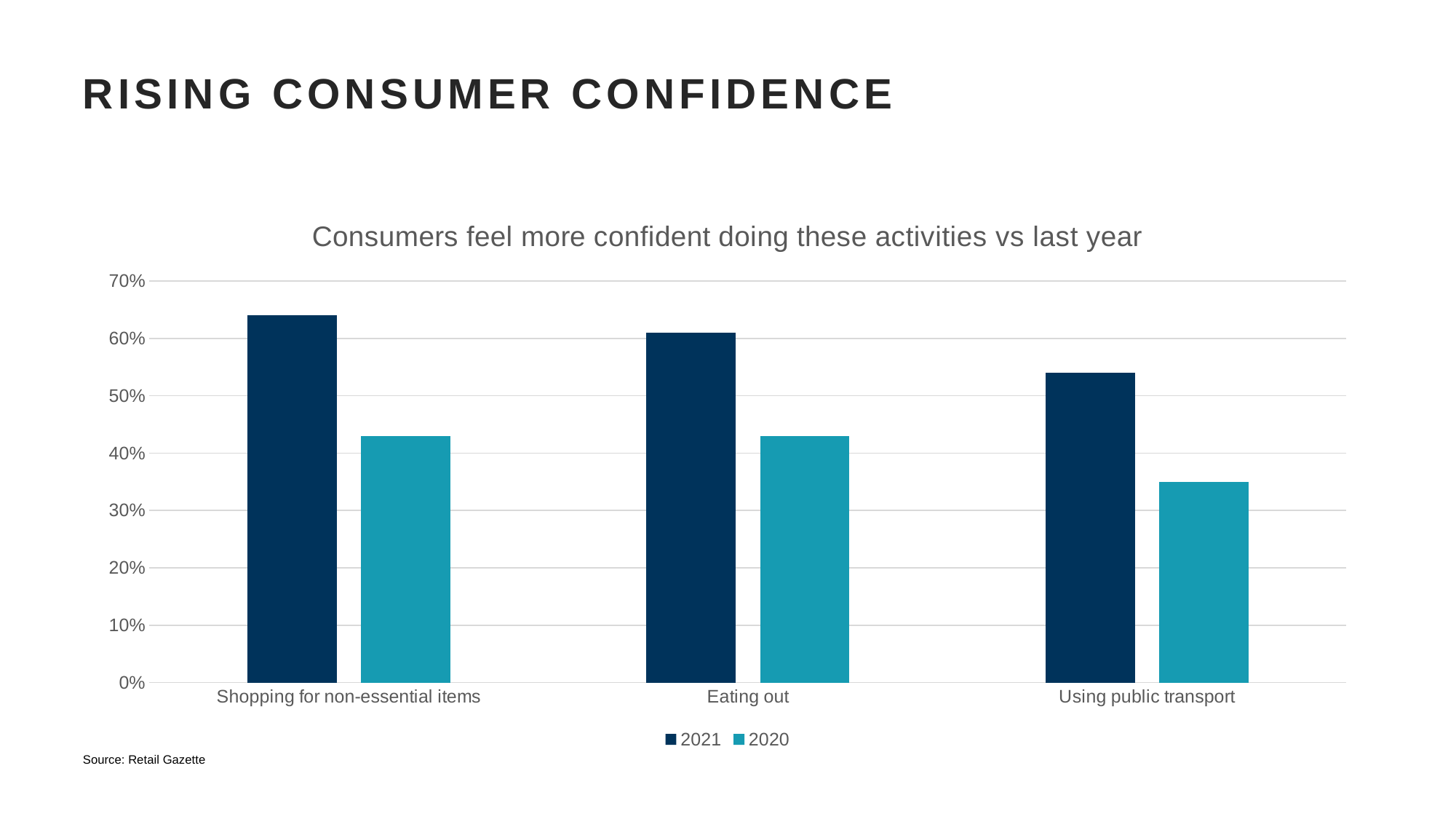
Is the 2021 value for Using public transport greater or less than 50%? greater Which activity has the lowest value for 2021? Using public transport Which activity has the lowest value for 2020? Using public transport What kind of chart is shown on the slide? bar chart Is the 2021 value for Shopping for non-essential items greater or less than 60%? greater Is the 2020 value for Using public transport greater or less than 40%? less Which activity has the highest value for 2021? Shopping for non-essential items What is the title of the chart? Consumers feel more confident doing these activities vs last year For Eating out, which series has the larger value, 2021 or 2020? 2021 How many activity categories are shown on the x axis? 3 How many series does the legend list? 2